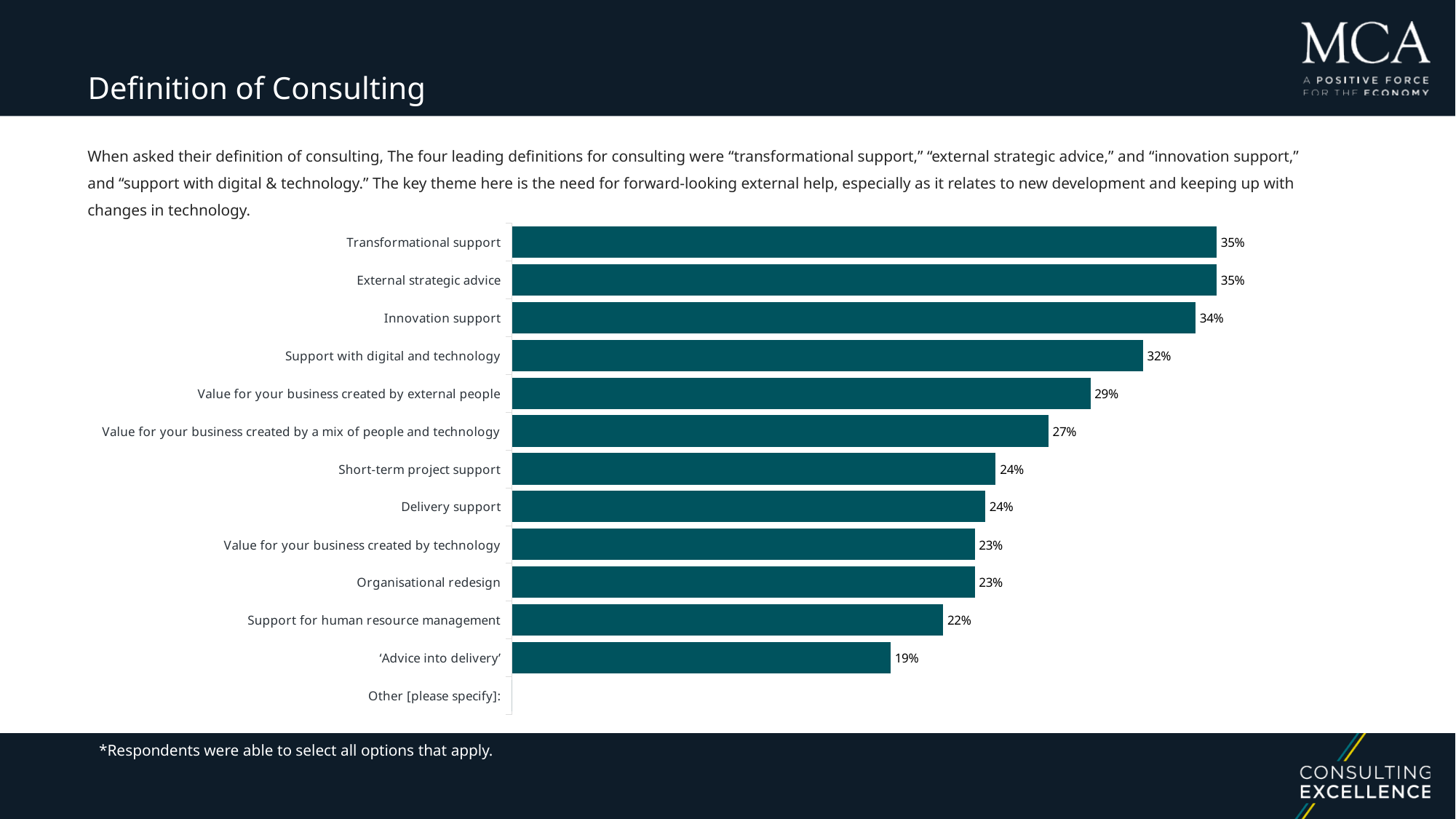
What is the value for Innovation support? 34% What is the value for Support for human resource management? 22% Which is larger, the value for Value for your business created by a mix of people and technology or the value for Delivery support? Value for your business created by a mix of people and technology What is the value for Support with digital and technology? 32% What is the value for 'Advice into delivery'? 19% What type of chart is shown on the slide? Bar chart What is the value for Value for your business created by external people? 29% How many categories are listed on the chart's vertical axis? 13 Which category with a labelled bar has the lowest value? 'Advice into delivery' What is the difference between the values for Transformational support and Short-term project support? 11% What is the title of the slide containing the chart? Definition of Consulting What is the difference between the values for Innovation support and Organisational redesign? 11%